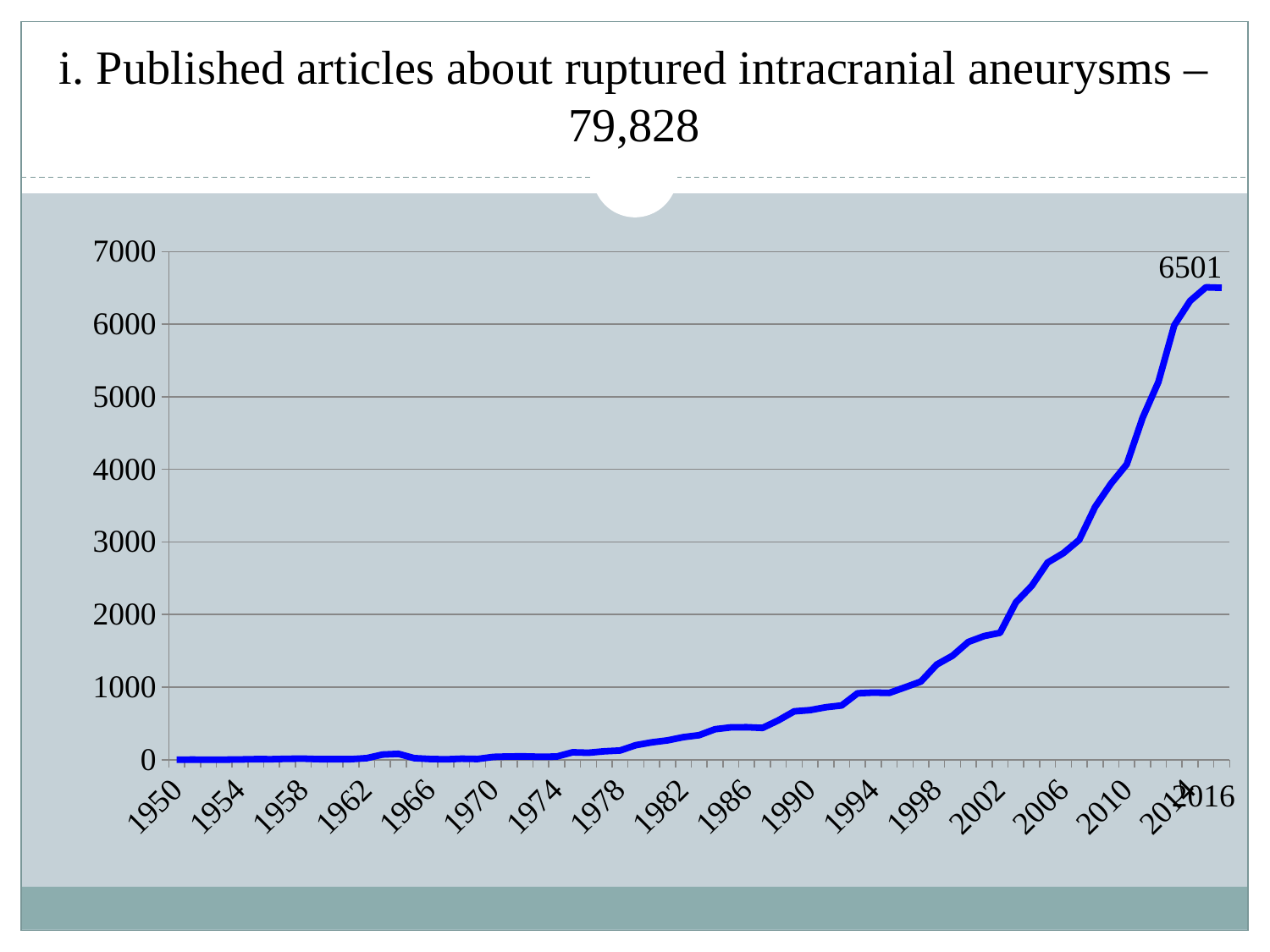
Is the value for 1970 greater or less than 1000? less What value is printed as the data label at the end of the line? 6501 What is the first year shown on the horizontal axis? 1950 Is the value for 2002 greater or less than 1000? greater What kind of chart is shown on the slide? line chart Is the value for 1990 greater or less than 1000? less Which year has the larger value, 2006 or 1990? 2006 Do the values generally rise or fall from 1950 to 2016? rise Which year has the larger value, 1982 or 2010? 2010 What is the highest value shown on the vertical axis? 7000